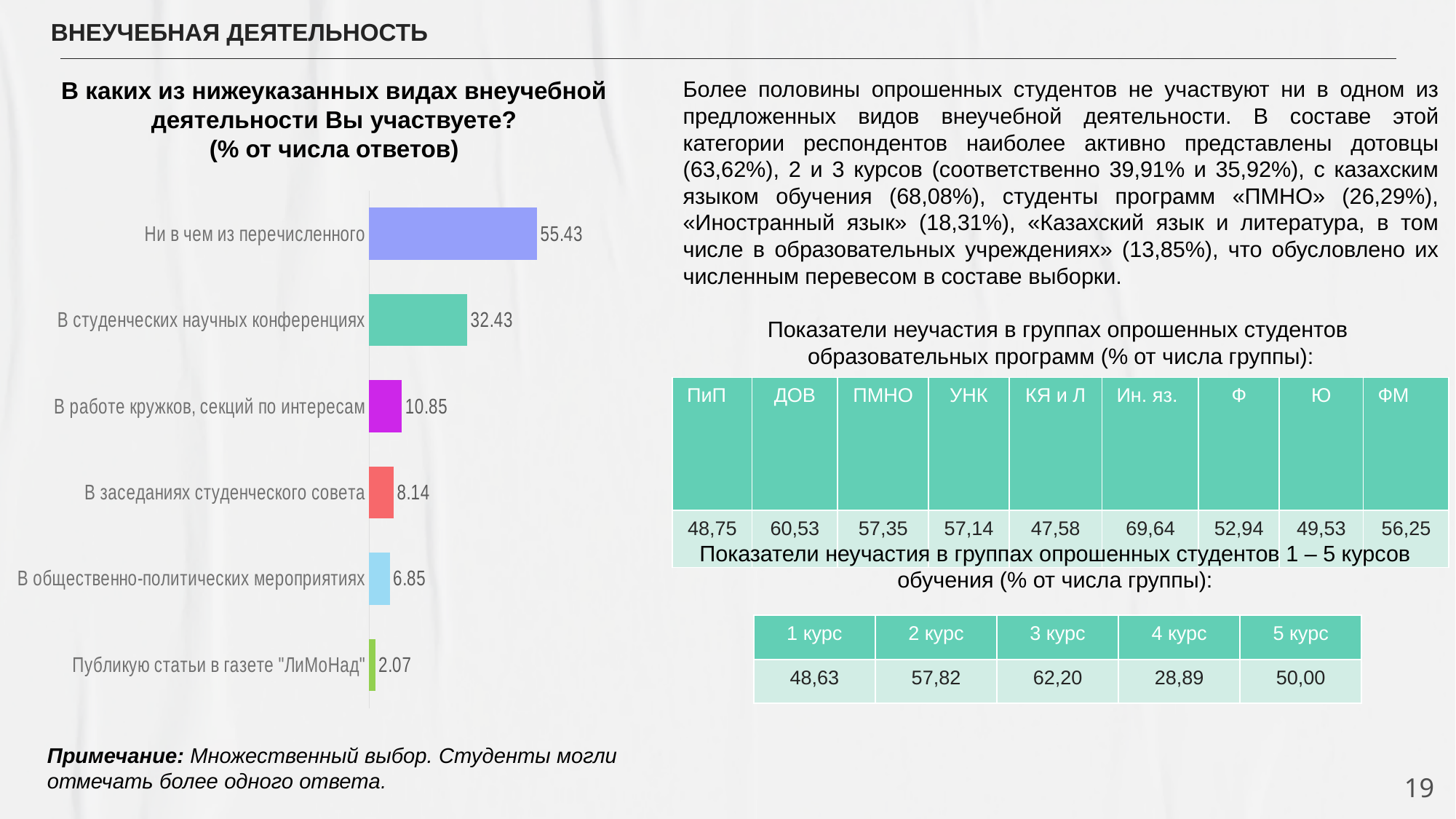
Which category has the lowest value in the bar chart? Публикую статьи в газете "ЛиМоНад" What is the difference between the values for "В работе кружков, секций по интересам" and "В заседаниях студенческого совета"? 2.71 How many categories are shown in the bar chart? 6 What is the value for "Ни в чем из перечисленного"? 55.43 What is the title of the bar chart? В каких из нижеуказанных видах внеучебной деятельности Вы участвуете? (% от числа ответов) What type of chart is shown on the slide? Bar chart Which category has the highest value in the bar chart? Ни в чем из перечисленного Which is larger: the value for "В заседаниях студенческого совета" or the value for "В общественно-политических мероприятиях"? В заседаниях студенческого совета What is the difference between the values for "Ни в чем из перечисленного" and "В студенческих научных конференциях"? 23.00 What is the value for "В работе кружков, секций по интересам"? 10.85 What is the value for "Публикую статьи в газете "ЛиМоНад""? 2.07 What is the value for "В студенческих научных конференциях"? 32.43